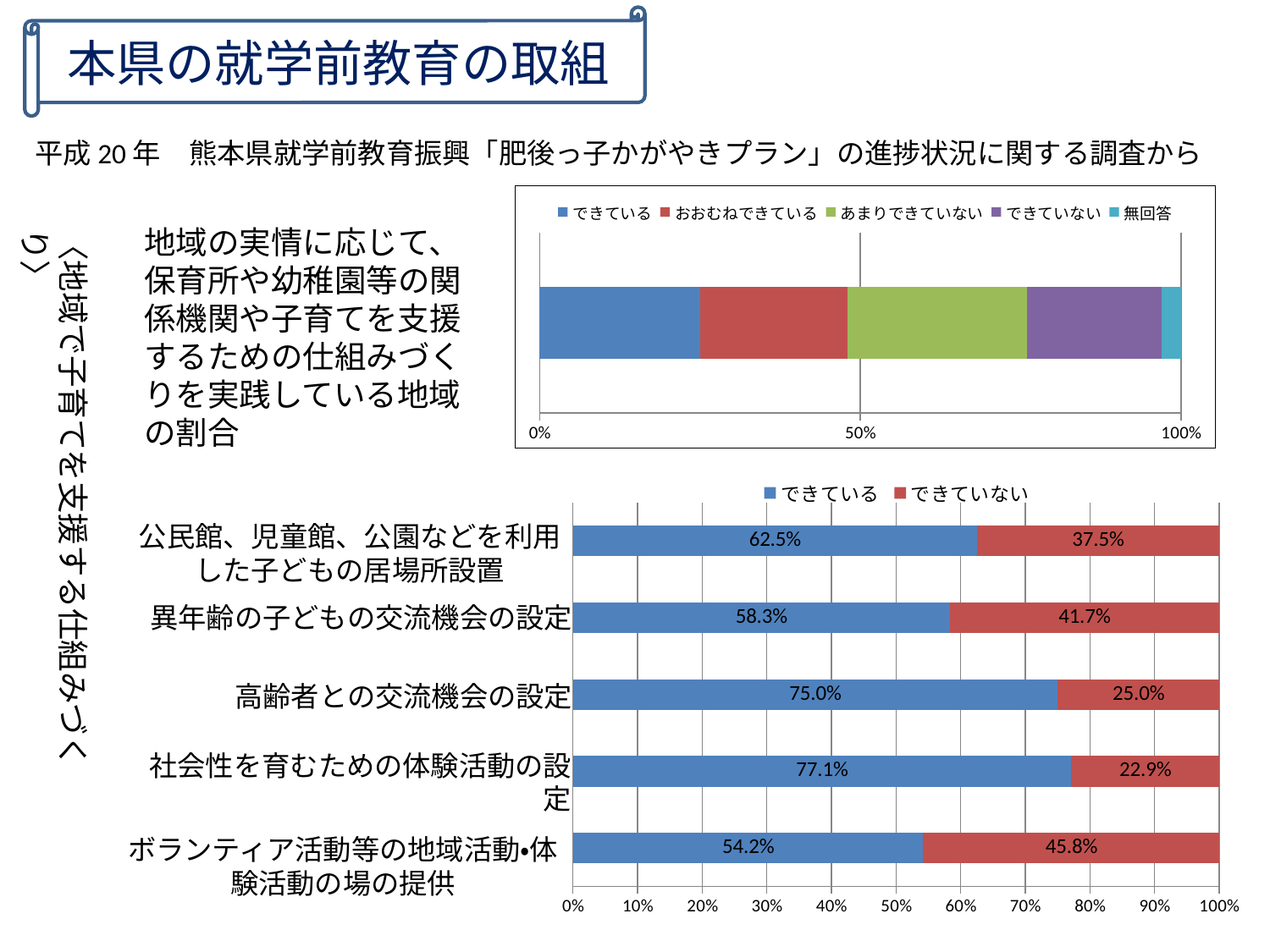
In the bottom chart, which is larger: the できていない value for 公民館、児童館、公園などを利用した子どもの居場所設置 or for ボランティア活動等の地域活動・体験活動の場の提供? ボランティア活動等の地域活動・体験活動の場の提供 In the bottom chart, what is the difference between the できている values for 社会性を育むための体験活動の設定 and 高齢者との交流機会の設定? 2.1% In the top chart, is the value for できている greater or less than 50%? less How many categories are shown in the bottom chart? 5 In the bottom chart, what is the total of the stacked bar for 異年齢の子どもの交流機会の設定? 100% In the bottom chart, which category has the lowest できている value? ボランティア活動等の地域活動・体験活動の場の提供 In the bottom chart, what is the できている value for 高齢者との交流機会の設定? 75.0% How many series does the legend of the top chart list? 5 What kind of chart is the top chart? stacked bar chart How many series does the legend of the bottom chart list? 2 In the bottom chart, what is the できていない value for 異年齢の子どもの交流機会の設定? 41.7% In the bottom chart, which category has the highest できている value? 社会性を育むための体験活動の設定